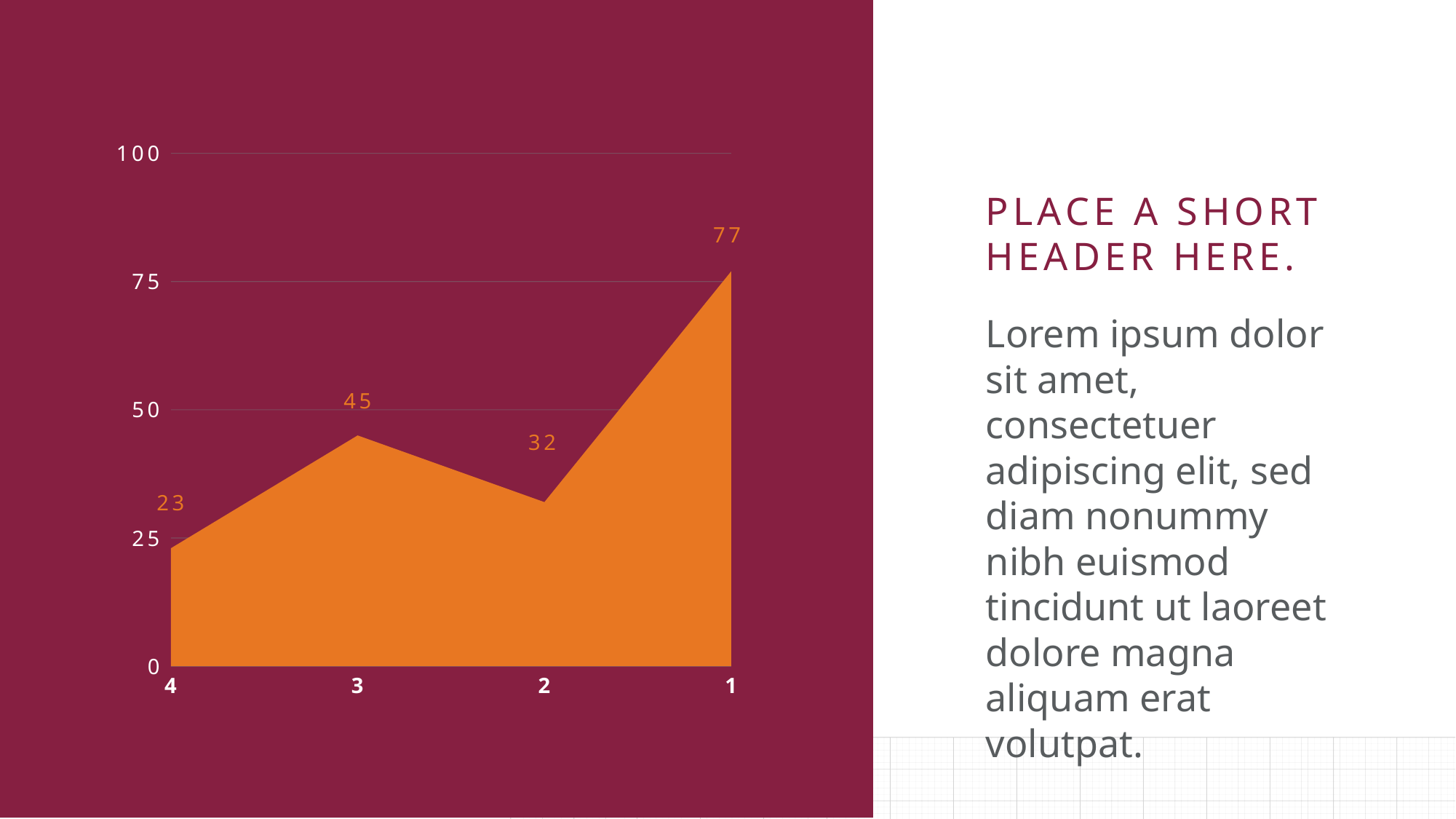
How many categories are plotted on the x axis? 4 What is the value for category 1? 77 Is the value for category 1 greater or less than 75? greater What is the difference between the values for category 3 and category 2? 13 Which is larger, the value for category 2 or the value for category 4? category 2 Which category has the highest value? 1 What is the value for category 4? 23 What is the difference between the values for category 1 and category 3? 32 What is the value for category 3? 45 Which category has the lowest value? 4 What is the value for category 2? 32 What kind of chart is shown on the slide? area chart